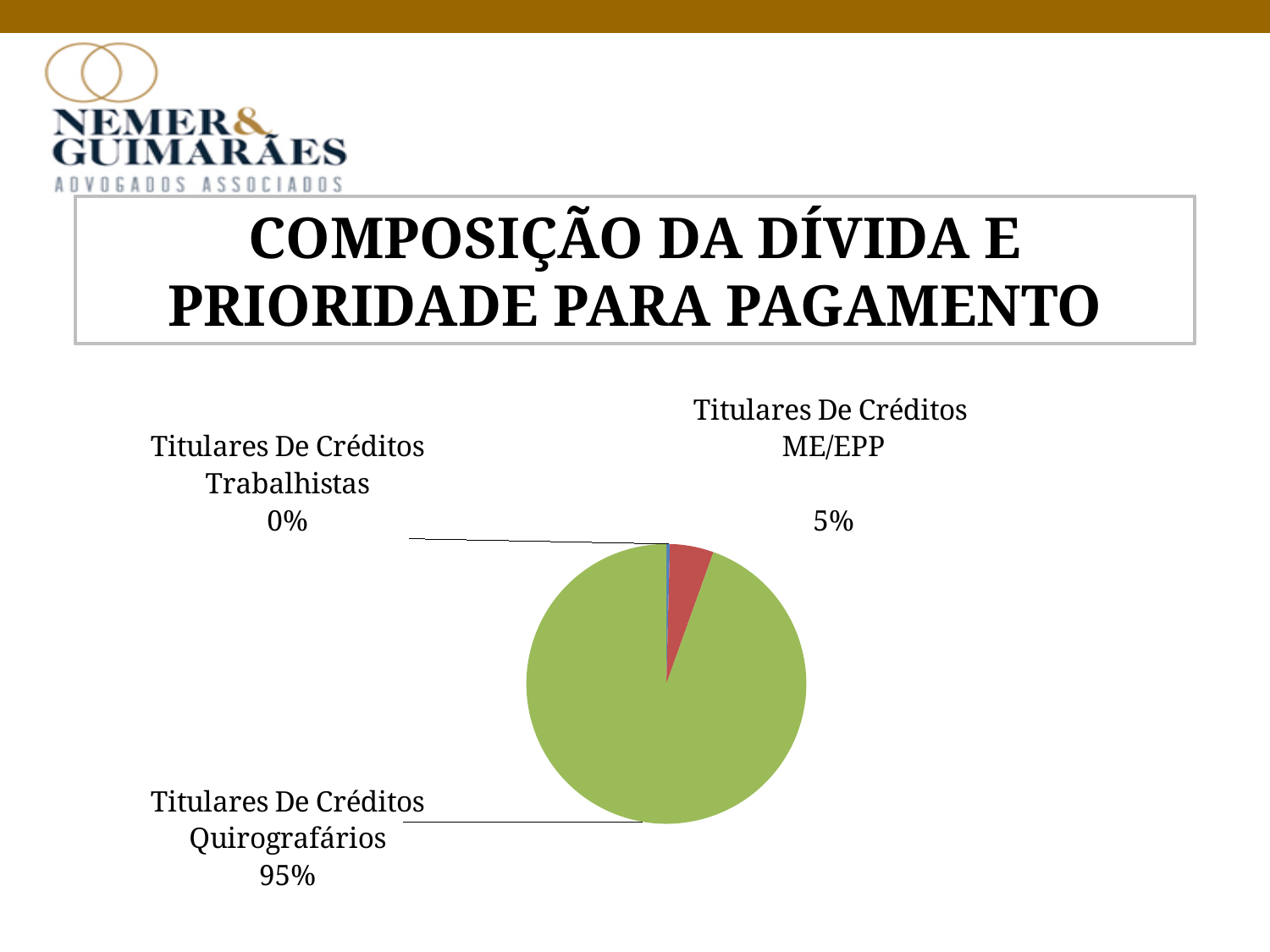
Which category has the smallest slice of the pie? Titulares De Créditos Trabalhistas Which is larger, the slice for Titulares De Créditos ME/EPP or the slice for Titulares De Créditos Trabalhistas? Titulares De Créditos ME/EPP What is the difference in percentage points between Titulares De Créditos Quirografários and Titulares De Créditos ME/EPP? 90 percentage points What kind of chart is shown on the slide? pie chart Which category has the largest slice of the pie? Titulares De Créditos Quirografários How many categories are shown in the pie chart? 3 What share of the pie is labelled for Titulares De Créditos Quirografários? 95% What colour is the slice for Titulares De Créditos Quirografários? green What share of the pie is labelled for Titulares De Créditos ME/EPP? 5% What share of the pie is labelled for Titulares De Créditos Trabalhistas? 0% What is the title shown above the chart on the slide? COMPOSIÇÃO DA DÍVIDA E PRIORIDADE PARA PAGAMENTO